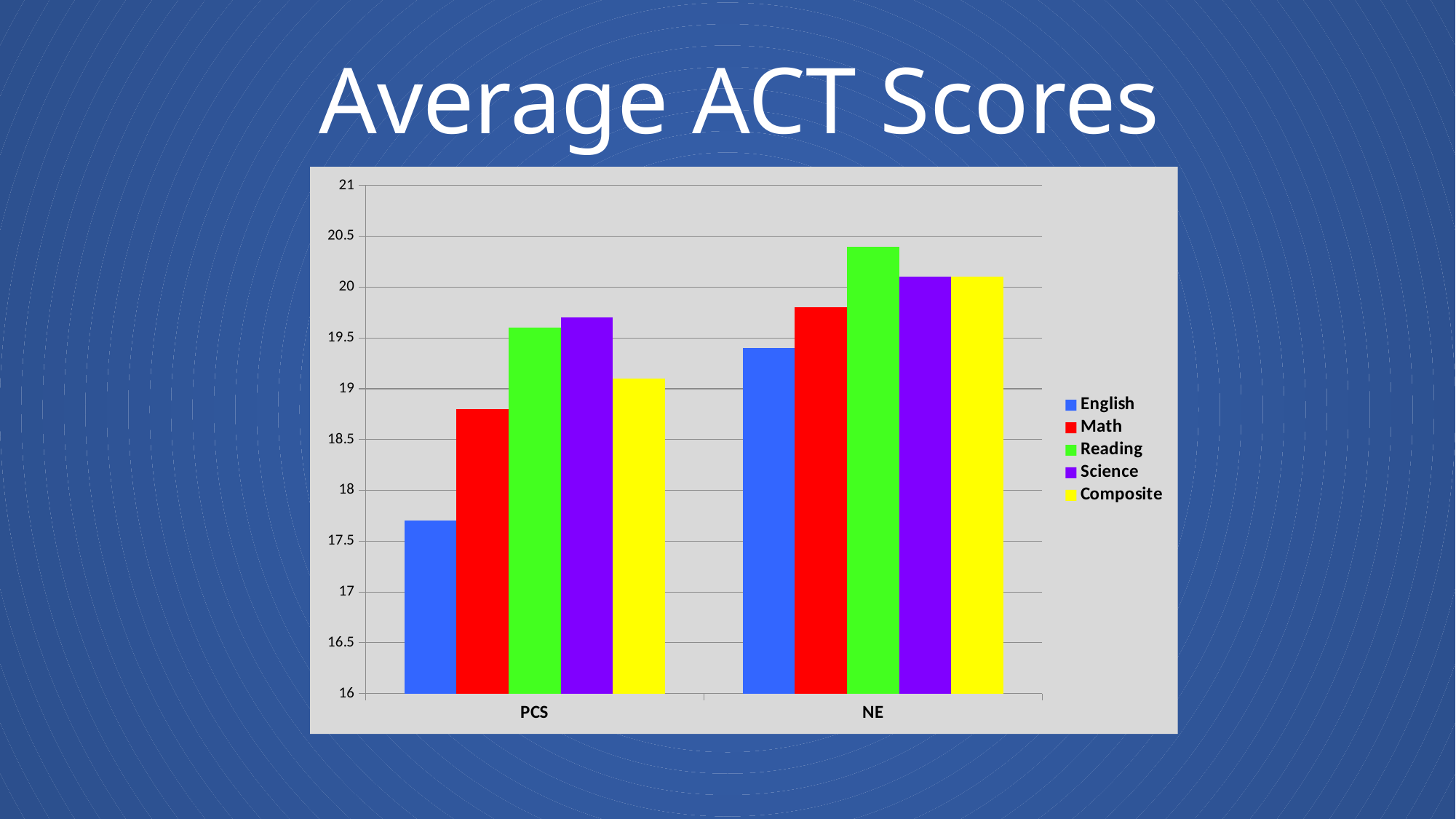
Which series has the lowest value for PCS? English Which series has the highest value for NE? Reading What is the title of the slide? Average ACT Scores How many series does the legend list? 5 Is the Math value for PCS greater or less than 19? less Which series has the lowest value for NE? English Is the Math value for NE greater or less than 20? less How many categories are shown on the x axis? 2 Which is larger, the English value for PCS or the English value for NE? NE Is the Reading value for NE greater or less than 20? greater What kind of chart is shown on the slide? bar chart